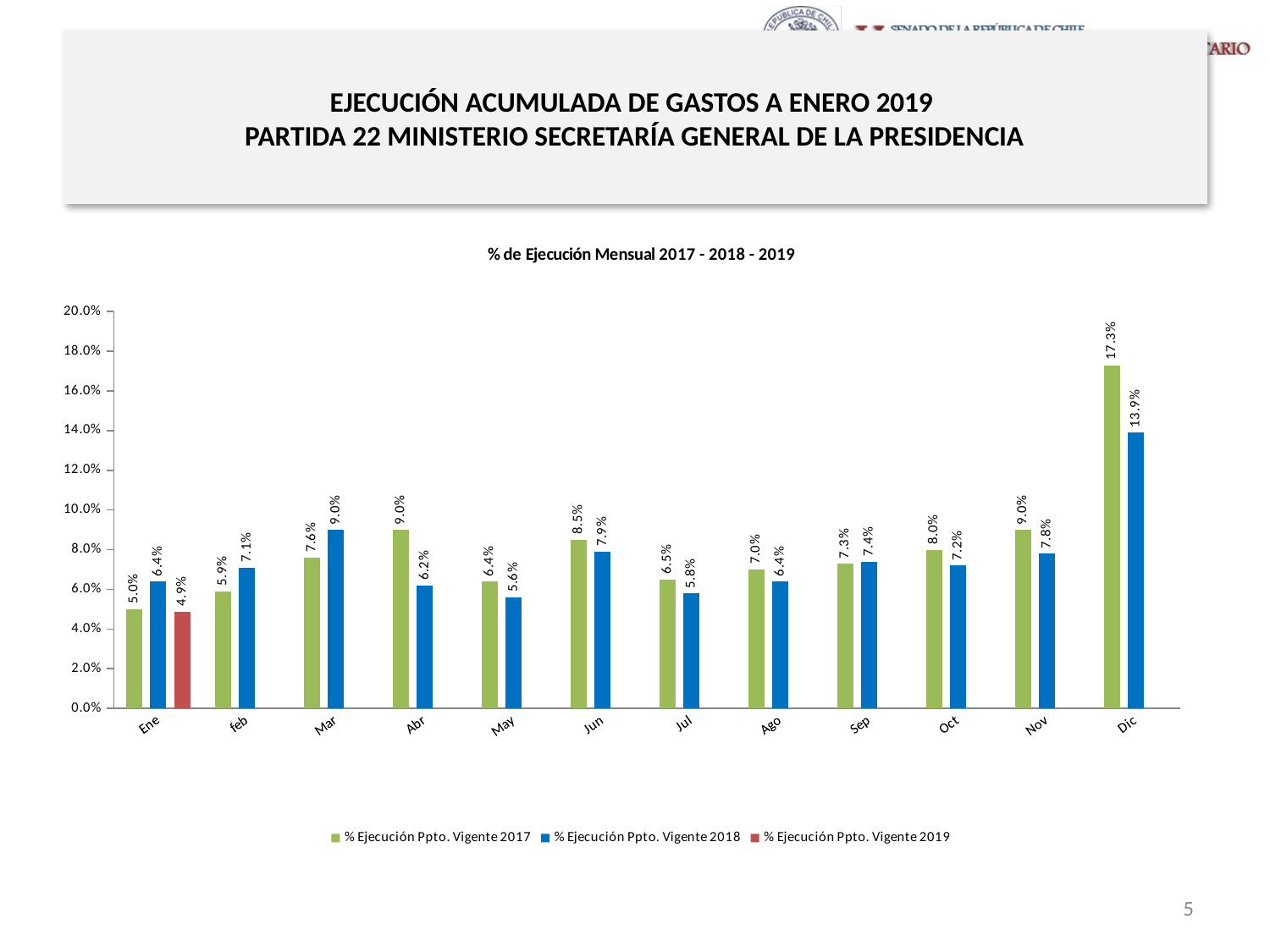
What is the value for % Ejecución Ppto. Vigente 2017 in Dic? 17.3% Is the value for % Ejecución Ppto. Vigente 2017 in Dic greater or less than 16.0%? greater What is the difference between the 2017 and 2018 values in Dic? 3.4% Which month has the highest value for % Ejecución Ppto. Vigente 2018? Dic How many series does the legend list? 3 What is the value for % Ejecución Ppto. Vigente 2019 in Ene? 4.9% How many months are shown on the x axis? 12 In Mar, which series has the larger value: % Ejecución Ppto. Vigente 2017 or % Ejecución Ppto. Vigente 2018? % Ejecución Ppto. Vigente 2018 Which month has the lowest value for % Ejecución Ppto. Vigente 2017? Ene What kind of chart is shown on the slide? Bar chart What is the value for % Ejecución Ppto. Vigente 2018 in May? 5.6% What is the title of the chart? % de Ejecución Mensual 2017 - 2018 - 2019